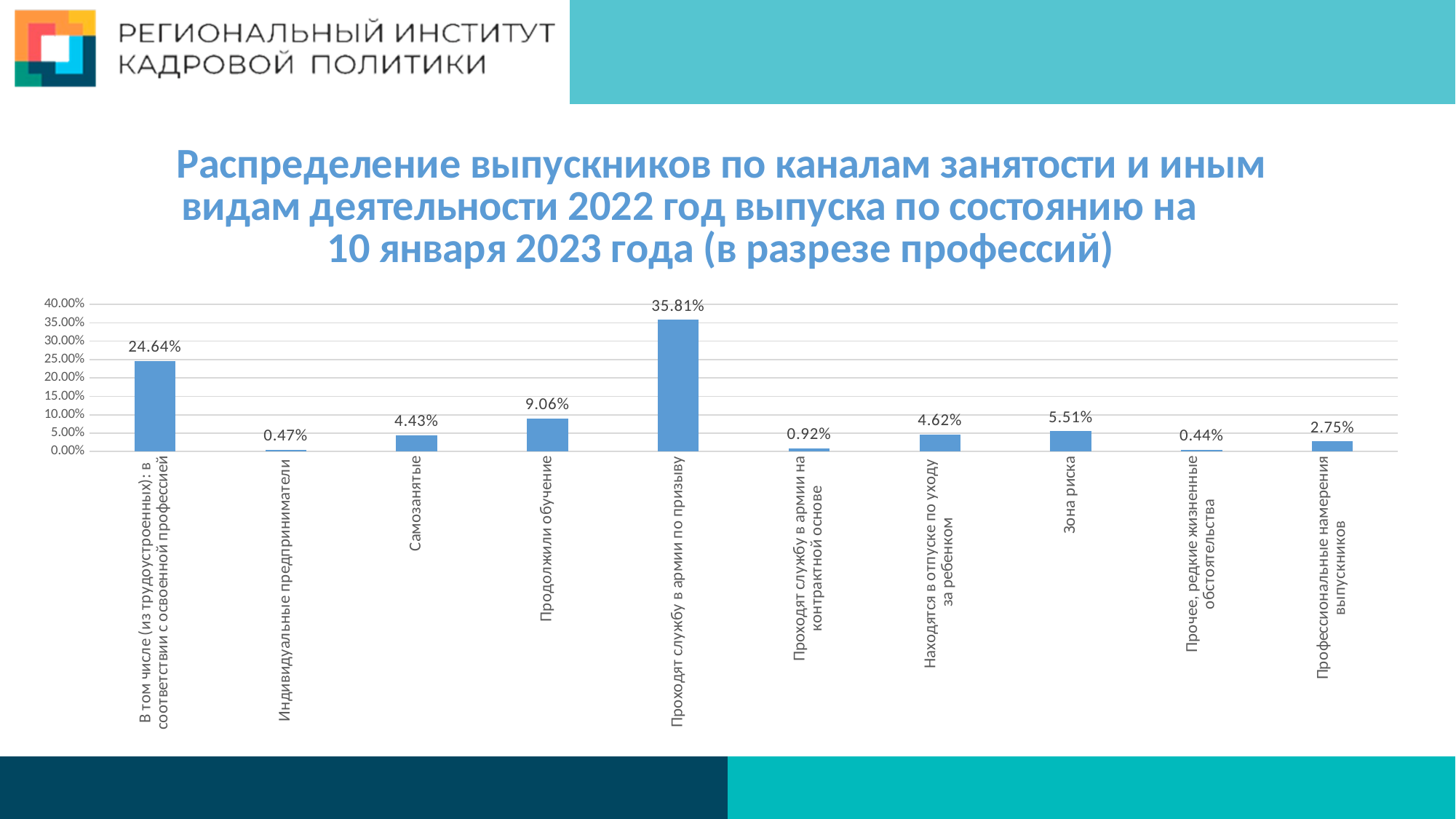
Is the value for «Продолжили обучение» greater or less than 10.00%? less Which is larger: «Находятся в отпуске по уходу за ребенком» or «Зона риска»? Зона риска What is the value for «Самозанятые»? 4.43% What is the value for «Проходят службу в армии по призыву»? 35.81% What is the value for «Продолжили обучение»? 9.06% What is the difference between «Проходят службу в армии по призыву» and «В том числе (из трудоустроенных): в соответствии с освоенной профессией»? 11.17% Which category has the highest value? Проходят службу в армии по призыву Which category has the lowest value? Прочее, редкие жизненные обстоятельства What is the value for «Профессиональные намерения выпускников»? 2.75% What kind of chart is shown on the slide? bar chart What is the value for «Зона риска»? 5.51% How many categories are shown on the x axis? 10